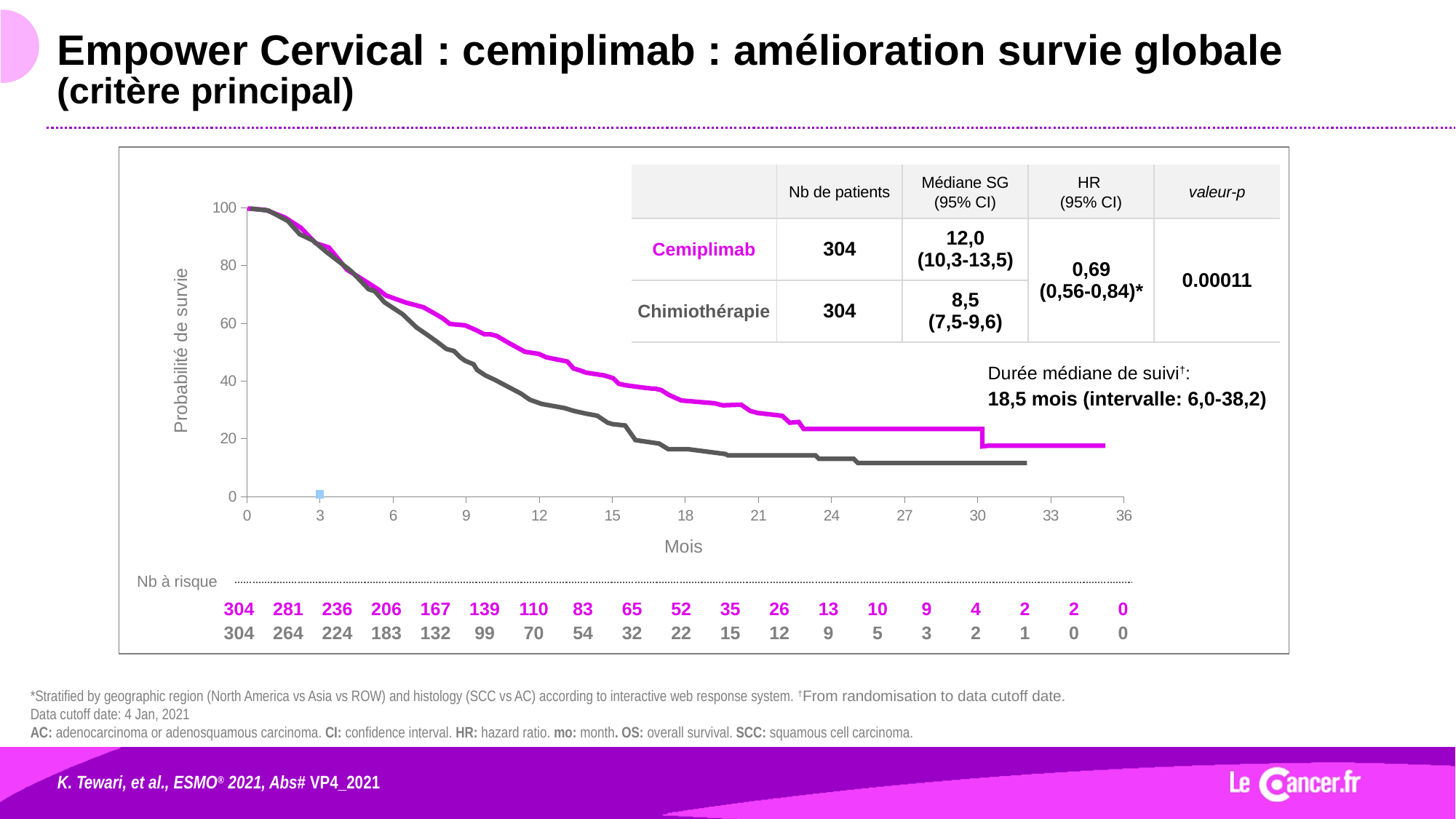
At 18 months, which curve is higher, Cemiplimab or Chimiothérapie? Cemiplimab Do the survival curves rise or fall as months increase along the x axis? fall Which treatment group has the higher median overall survival? Cemiplimab What is the hazard ratio (HR) reported in the table? 0,69 (0,56-0,84)* At 24 months, is the survival probability for the Chimiothérapie (grey) curve greater or less than 20? less What kind of chart is shown on the slide? Line chart (Kaplan-Meier survival curve) How many survival curves (treatment groups) are plotted on the chart? 2 According to the table, what is the median overall survival (Médiane SG) for Chimiothérapie? 8,5 (7,5-9,6) What is the label of the y axis of the chart? Probabilité de survie What is the difference in median overall survival between Cemiplimab and Chimiothérapie? 3,5 mois According to the table, what is the median overall survival (Médiane SG) for Cemiplimab? 12,0 (10,3-13,5) At 12 months, is the survival probability for the Cemiplimab (magenta) curve greater or less than 40? greater